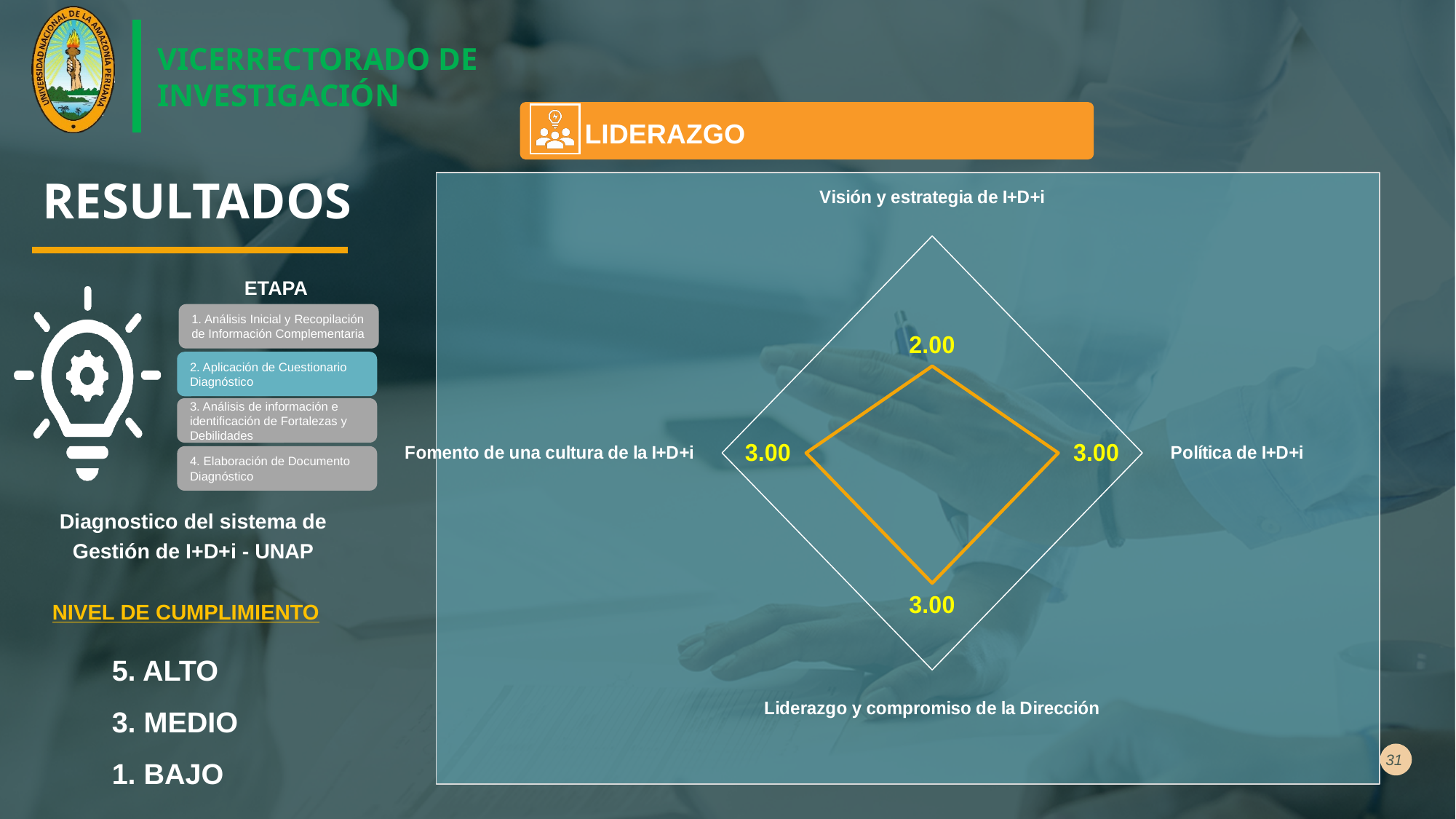
What is the value for Liderazgo y compromiso de la Dirección on the radar chart? 3.00 What is the difference between the value for Política de I+D+i and the value for Visión y estrategia de I+D+i? 1.00 What is the title shown in the orange banner above the chart? LIDERAZGO Is the value for Visión y estrategia de I+D+i greater or less than 3? less Which category has the lowest value on the radar chart? Visión y estrategia de I+D+i How many categories (axes) does the radar chart have? 4 What is the value for Fomento de una cultura de la I+D+i on the radar chart? 3.00 What is the value for Visión y estrategia de I+D+i on the radar chart? 2.00 What is the value for Política de I+D+i on the radar chart? 3.00 Which is larger: the value for Liderazgo y compromiso de la Dirección or the value for Visión y estrategia de I+D+i? Liderazgo y compromiso de la Dirección What colour is the data line plotted on the radar chart? Orange What kind of chart is shown on the slide? Radar chart